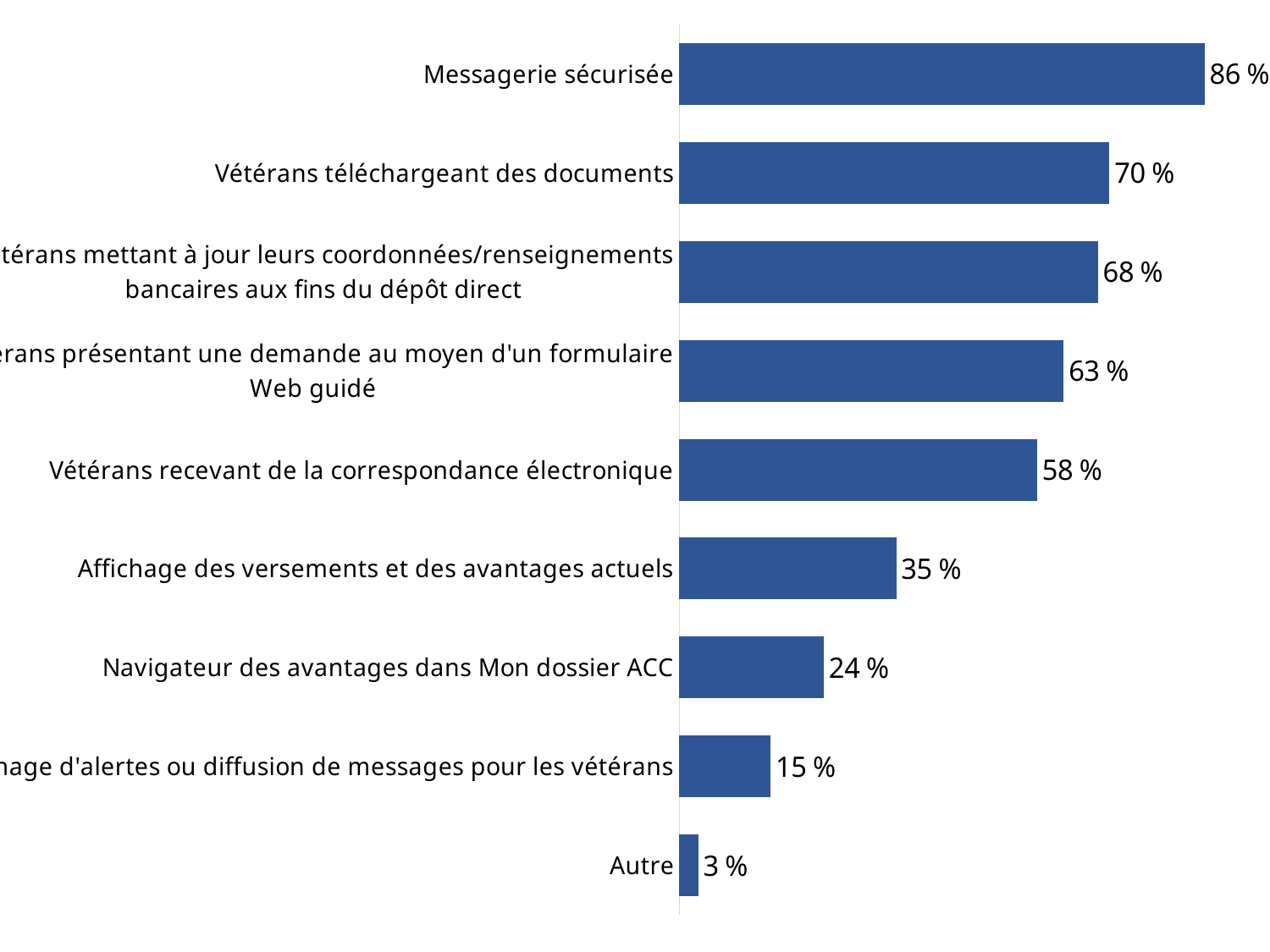
What is the value for Autre? 3 % What is the difference between the values for Messagerie sécurisée and Vétérans téléchargeant des documents? 16 % What is the value for Navigateur des avantages dans Mon dossier ACC? 24 % Which category has the lowest value? Autre What is the value for Vétérans téléchargeant des documents? 70 % What is the value for Messagerie sécurisée? 86 % What is the value for Affichage des versements et des avantages actuels? 35 % Which category has the highest value? Messagerie sécurisée How many categories are shown in the chart? 9 What kind of chart is shown on the slide? bar chart What is the value for Vétérans recevant de la correspondance électronique? 58 % Which is larger, the value for Affichage des versements et des avantages actuels or the value for Navigateur des avantages dans Mon dossier ACC? Affichage des versements et des avantages actuels